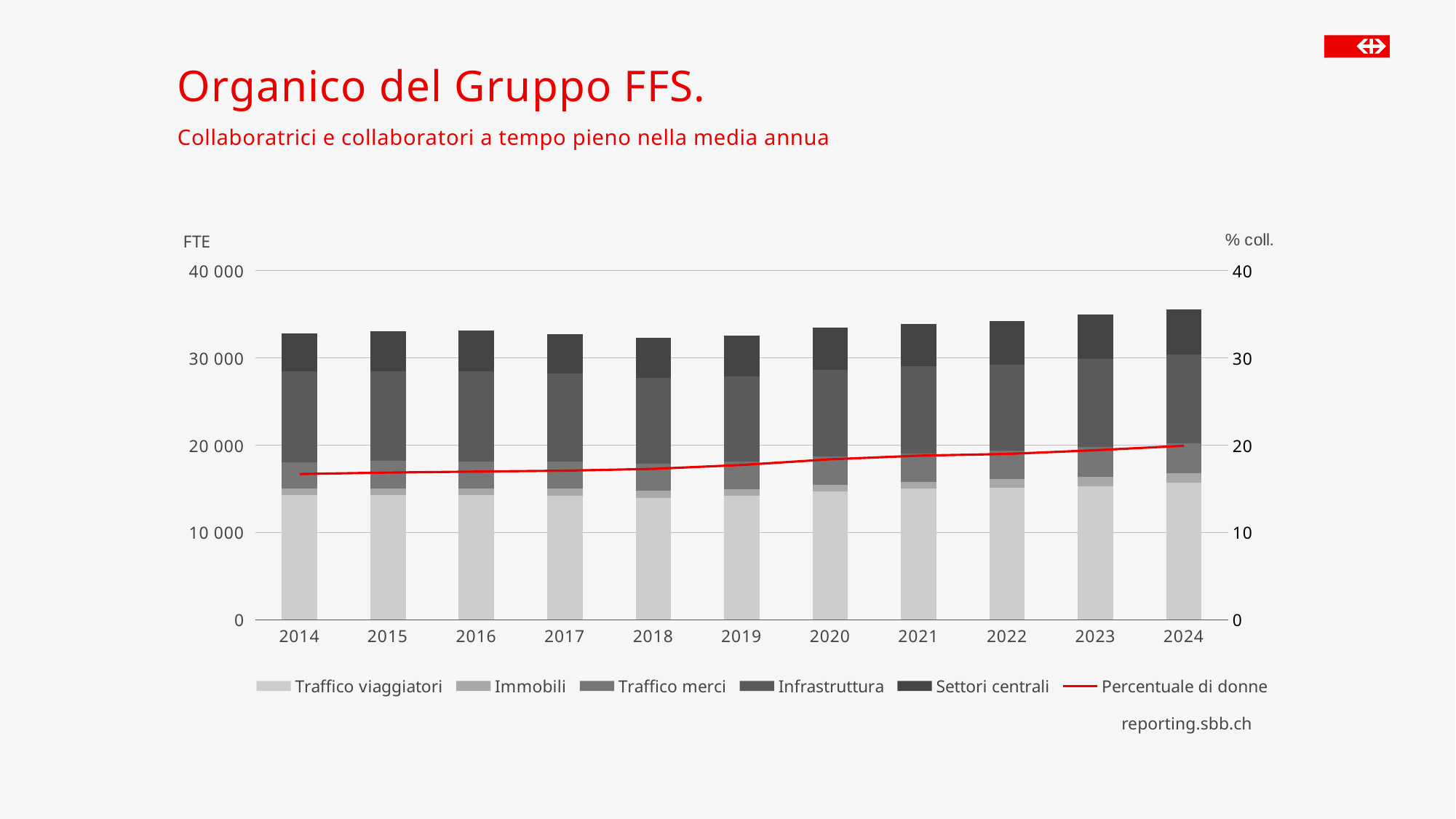
Which year has the highest total FTE bar? 2024 How many series does the legend list? 6 Is the Traffico viaggiatori segment for 2014 greater or less than 10 000? greater How many years are shown on the x axis of the chart? 11 Is the Percentuale di donne value for 2014 greater or less than 20? less Is the total FTE bar for 2024 greater or less than 40 000? less Which total FTE bar is larger, 2014 or 2024? 2024 What kind of chart is shown on the slide? Stacked bar chart with a line Does the Percentuale di donne line rise or fall from 2014 to 2024? rise What label is shown on the right-hand vertical axis? % coll. What is the title of the chart slide? Organico del Gruppo FFS.